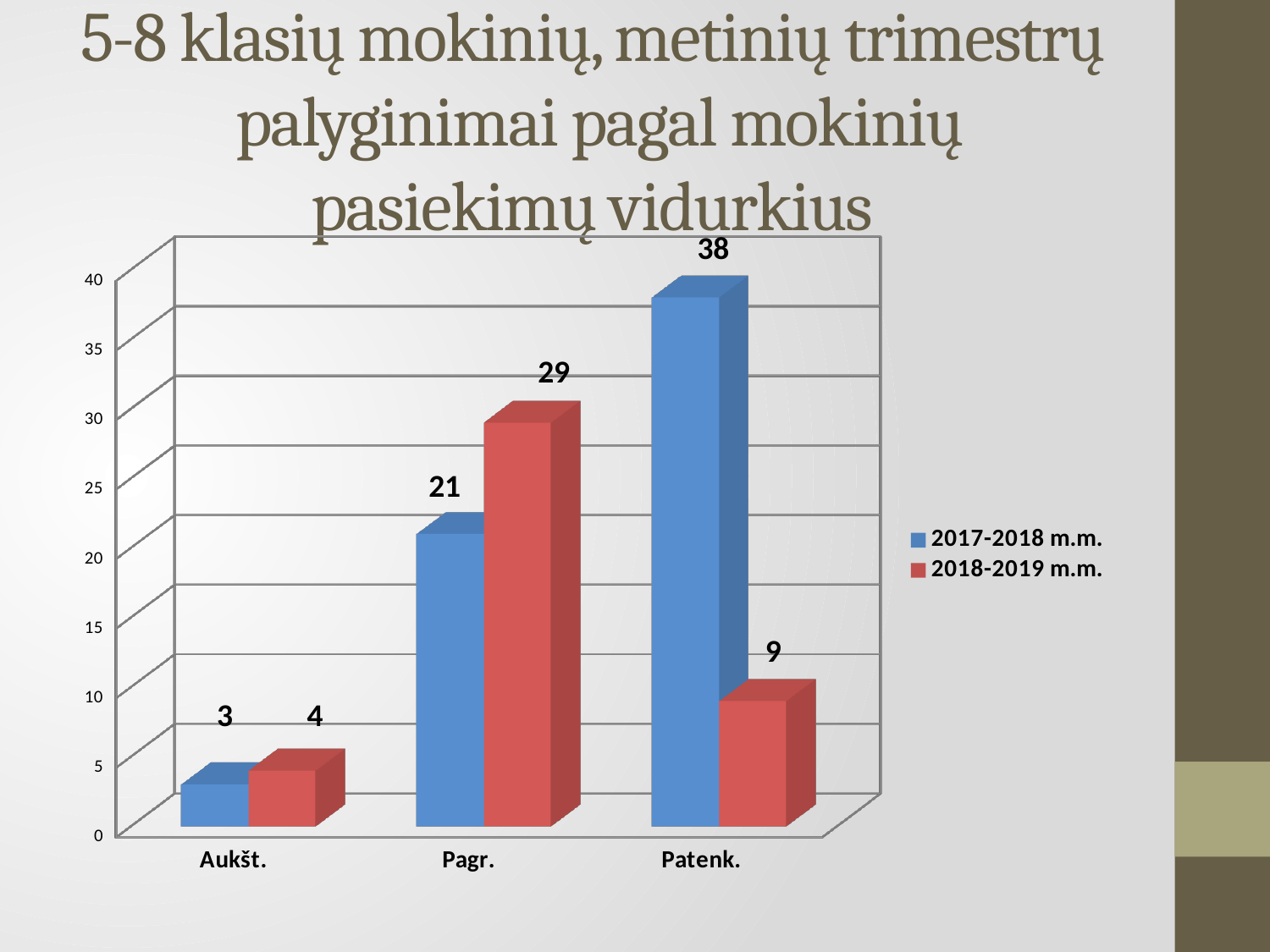
What is the value for Pagr. in the 2018-2019 m.m. series? 29 How many series does the legend list? 2 Which category has the lowest value in the 2018-2019 m.m. series? Aukšt. Which category has the highest value in the 2017-2018 m.m. series? Patenk. What is the value for Patenk. in the 2017-2018 m.m. series? 38 What colour represents the 2018-2019 m.m. series? Red What kind of chart is shown on the slide? Bar chart How many categories are shown on the x axis? 3 What is the value for Patenk. in the 2018-2019 m.m. series? 9 What is the value for Aukšt. in the 2017-2018 m.m. series? 3 What is the difference between the 2017-2018 m.m. and 2018-2019 m.m. values for Patenk.? 29 Which series has the larger value for Pagr., 2017-2018 m.m. or 2018-2019 m.m.? 2018-2019 m.m.